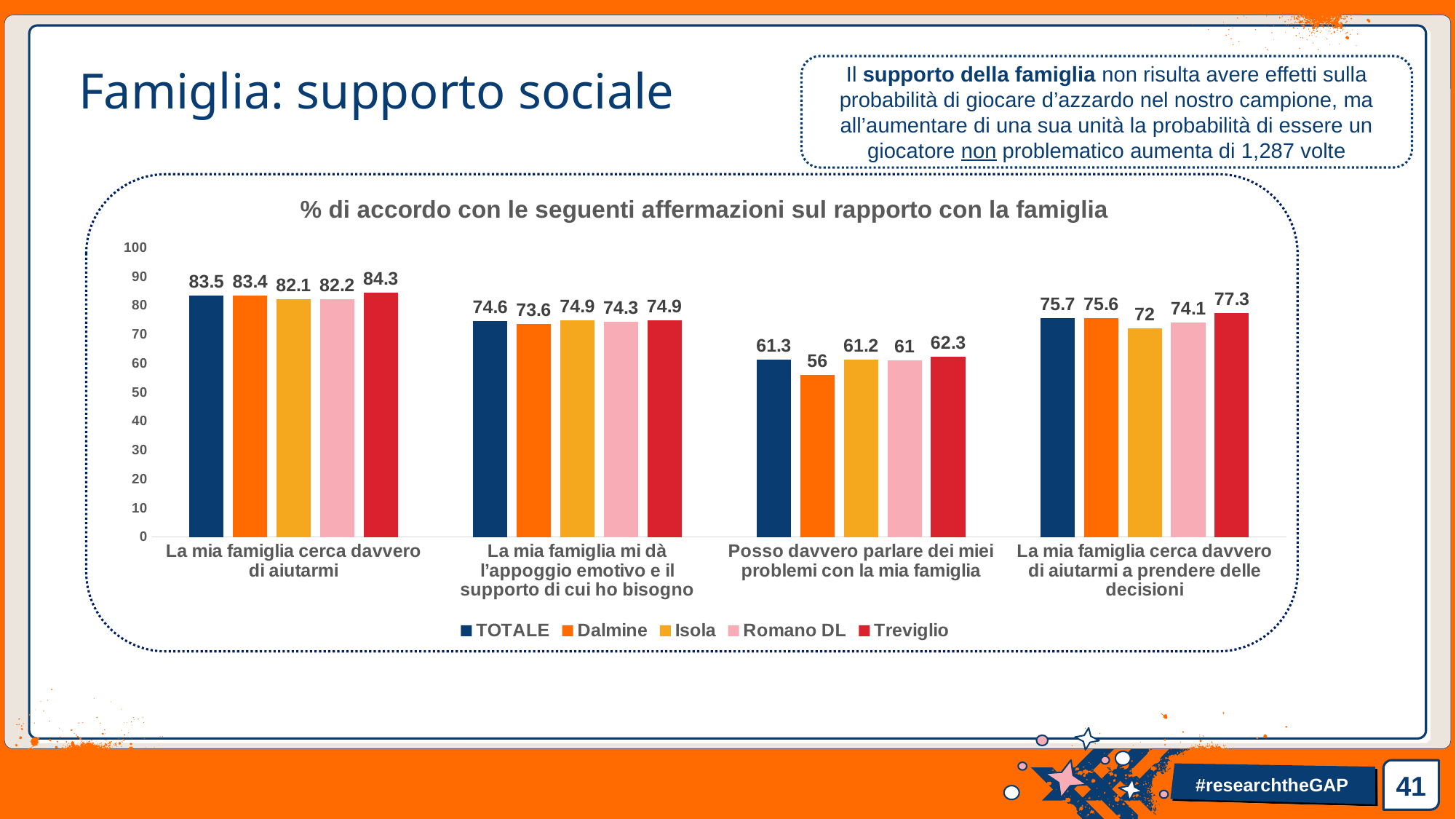
What is the value for Treviglio for the statement "La mia famiglia cerca davvero di aiutarmi"? 84.3 What is the TOTALE value for the statement "La mia famiglia mi dà l'appoggio emotivo e il supporto di cui ho bisogno"? 74.6 For the statement "La mia famiglia cerca davvero di aiutarmi a prendere delle decisioni", which is larger: the value for Romano DL or the value for Isola? Romano DL What is the title of the chart? % di accordo con le seguenti affermazioni sul rapporto con la famiglia How many series does the legend list? 5 Which series has the highest value for the statement "La mia famiglia cerca davvero di aiutarmi a prendere delle decisioni"? Treviglio What type of chart is shown on the slide? bar chart What is the value for Dalmine for the statement "Posso davvero parlare dei miei problemi con la mia famiglia"? 56 What is the difference between the Treviglio and Dalmine values for the statement "Posso davvero parlare dei miei problemi con la mia famiglia"? 6.3 How many statement categories are shown on the x axis? 4 What is the value for Isola for the statement "La mia famiglia cerca davvero di aiutarmi a prendere delle decisioni"? 72 Which series has the lowest value for the statement "Posso davvero parlare dei miei problemi con la mia famiglia"? Dalmine